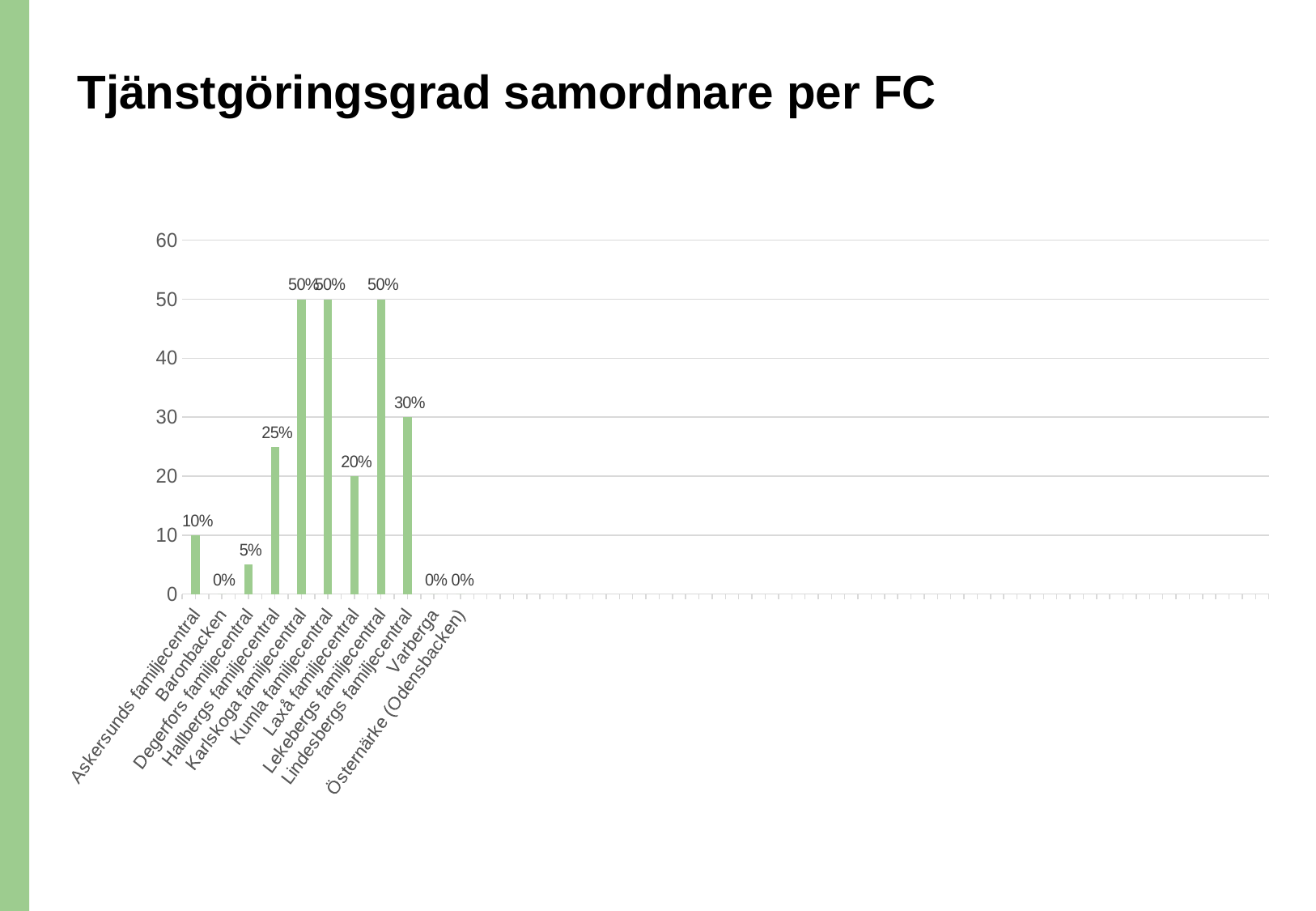
What is the value for Askersunds familjecentral? 10% What is the value for Lindesbergs familjecentral? 30% How many categories are labelled on the x axis? 11 What is the difference between the values for Hallbergs familjecentral and Degerfors familjecentral? 20% What kind of chart is shown on the slide? Bar chart What is the value for Hallbergs familjecentral? 25% What is the value for Laxå familjecentral? 20% Which is larger, the value for Laxå familjecentral or the value for Lindesbergs familjecentral? Lindesbergs familjecentral What is the value for Degerfors familjecentral? 5% What is the difference between the values for Karlskoga familjecentral and Lindesbergs familjecentral? 20% What is the title of the slide? Tjänstgöringsgrad samordnare per FC What is the value for Varberga? 0%